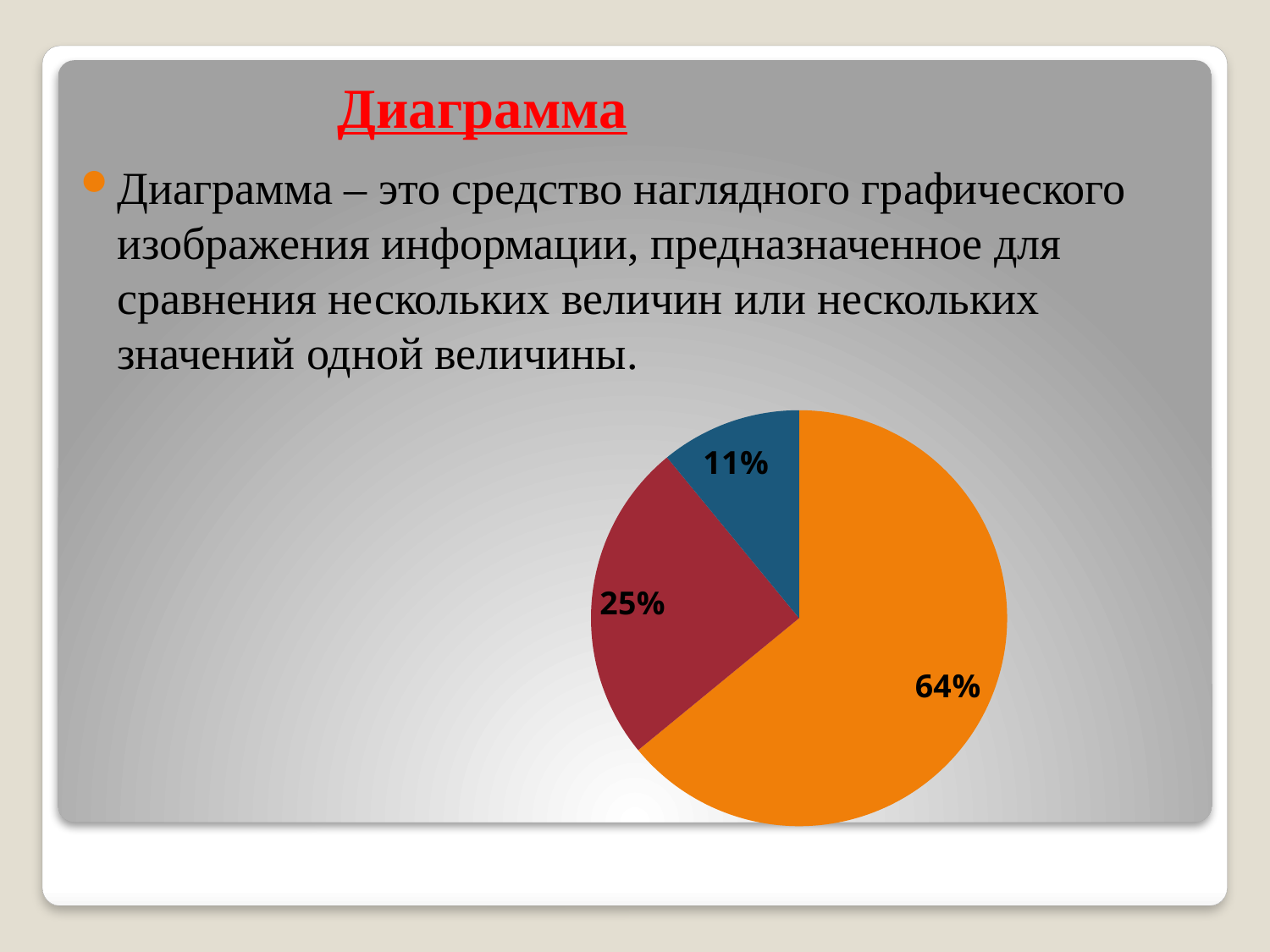
How many slices does the pie chart have? 3 What is the difference in percentage points between the red slice and the blue slice? 14 Which colour slice is the largest in the pie chart? orange What kind of chart is shown on the slide? pie chart What percentage is shown on the blue slice of the pie chart? 11% Does the pie chart have a legend? No What percentage is shown on the orange slice of the pie chart? 64% What do the three slice percentages in the pie chart add up to? 100% Which is larger, the red slice or the blue slice? red What percentage is shown on the red slice of the pie chart? 25% What is the difference in percentage points between the orange slice and the red slice? 39 Which colour slice is the smallest in the pie chart? blue